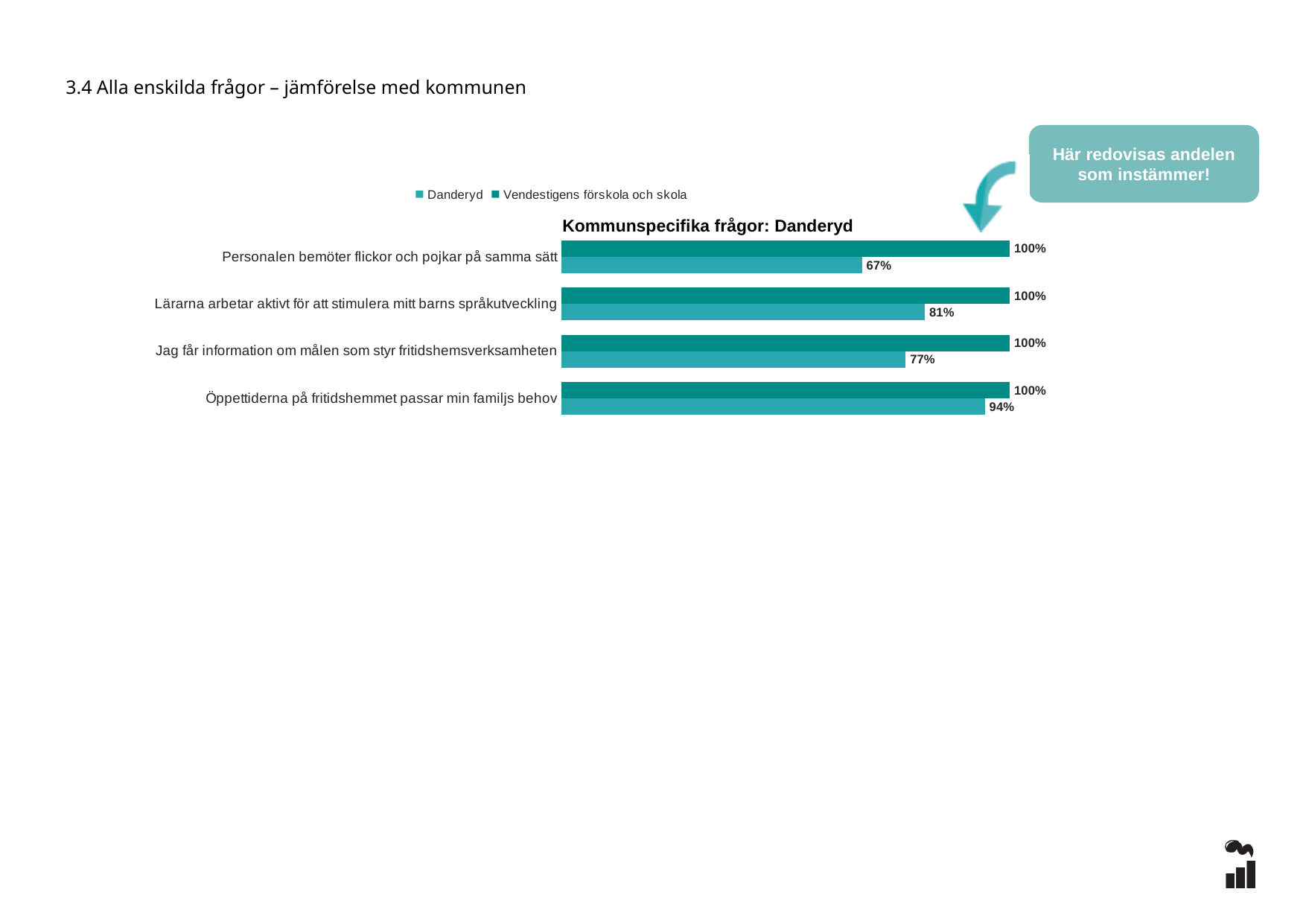
Which is larger for Danderyd: "Lärarna arbetar aktivt för att stimulera mitt barns språkutveckling" or "Jag får information om målen som styr fritidshemsverksamheten"? Lärarna arbetar aktivt för att stimulera mitt barns språkutveckling How many categories are shown in the chart? 4 What is the value for Danderyd on "Jag får information om målen som styr fritidshemsverksamheten"? 77% What is the difference between Vendestigens förskola och skola and Danderyd on "Personalen bemöter flickor och pojkar på samma sätt"? 33% Which category has the lowest value for Danderyd? Personalen bemöter flickor och pojkar på samma sätt What is the value for Danderyd on "Personalen bemöter flickor och pojkar på samma sätt"? 67% Which category has the highest value for Danderyd? Öppettiderna på fritidshemmet passar min familjs behov What is the title of the chart? Kommunspecifika frågor: Danderyd What is the value for Vendestigens förskola och skola on "Öppettiderna på fritidshemmet passar min familjs behov"? 100% What kind of chart is shown on the slide? Bar chart How many series does the legend list? 2 What is the value for Danderyd on "Lärarna arbetar aktivt för att stimulera mitt barns språkutveckling"? 81%